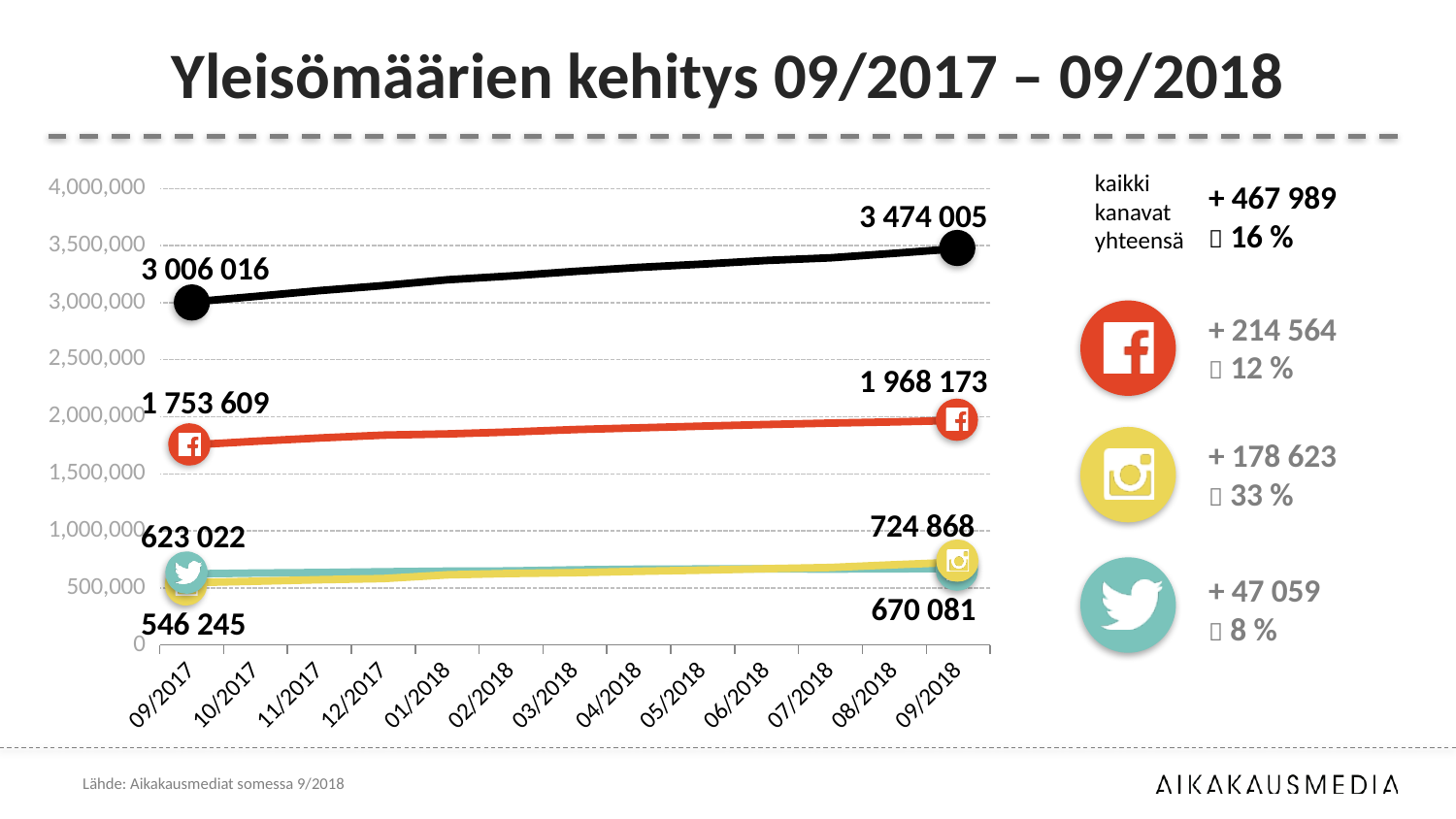
By how much did the red Facebook line increase from 09/2017 to 09/2018? 214 564 What is the value of the black (total) line at 09/2017? 3 006 016 How many months are shown on the x axis? 13 By how much did the black (total) line increase from 09/2017 to 09/2018? 467 989 What is the value of the black (total) line at 09/2018? 3 474 005 Which line has the highest value at 09/2018? The black (total) line What is the value of the yellow Instagram line at 09/2018? 724 868 Does the black (total) line rise or fall from 09/2017 to 09/2018? Rise Which is larger at 09/2018: the yellow Instagram line or the teal Twitter line? The yellow Instagram line What is the value of the red Facebook line at 09/2018? 1 968 173 What is the value of the red Facebook line at 09/2017? 1 753 609 What type of chart is shown on the slide? Line chart